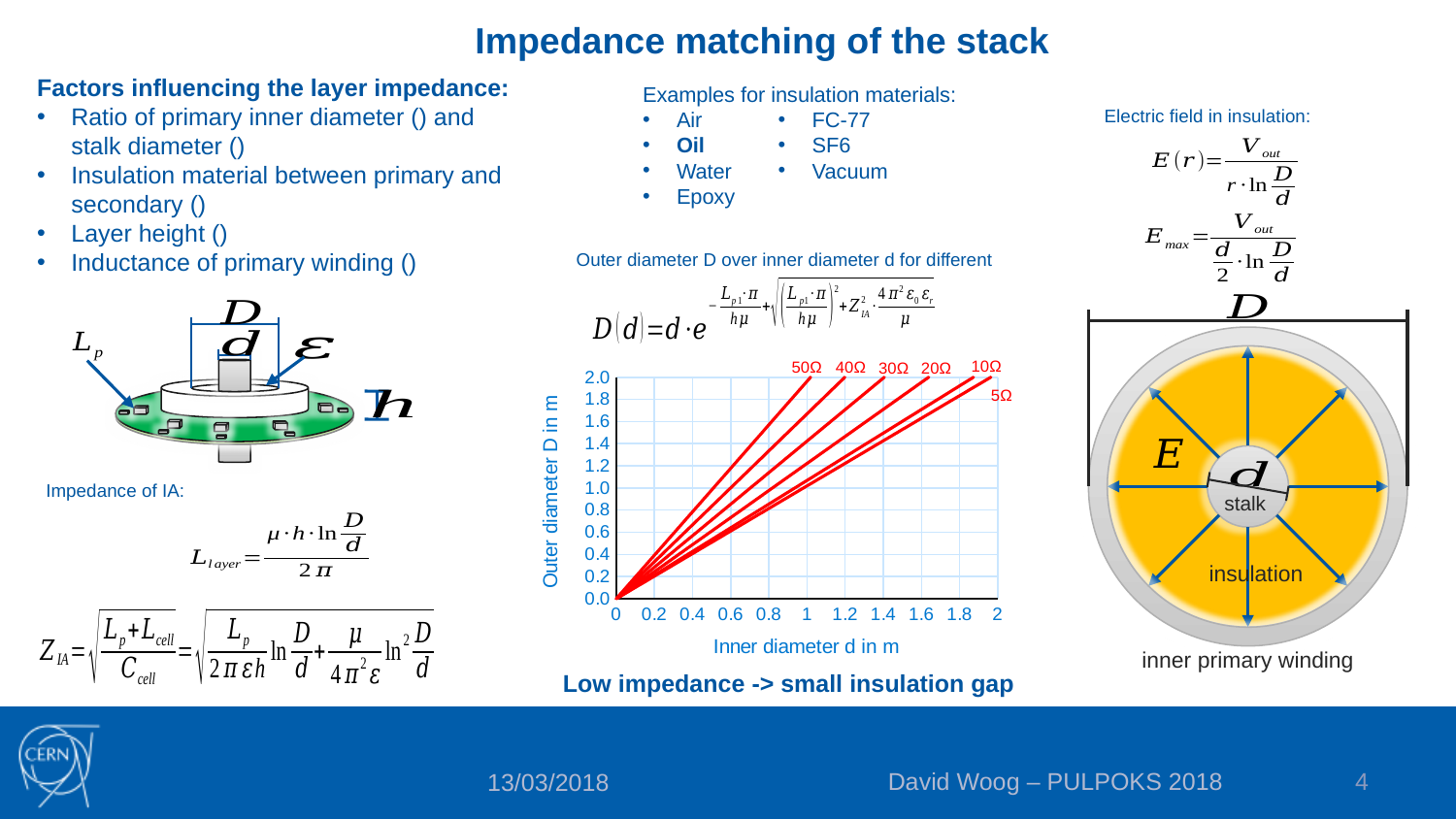
At an inner diameter of 1 m, is the outer diameter for the 50Ω curve greater or less than 1.6 m? greater What is the label of the y axis of the chart? Outer diameter D in m At an inner diameter of 0.5 m, is the outer diameter for the 50Ω curve greater or less than 0.8 m? greater Which impedance curve is the steepest in the chart? 50Ω Do the curves in the chart rise or fall as the inner diameter d increases? rise What kind of chart is shown on the slide? line chart What is the highest value shown on the y axis of the chart? 2.0 At the same inner diameter, which curve gives the larger outer diameter, 50Ω or 5Ω? 50Ω At an inner diameter of 1 m, is the outer diameter for the 5Ω curve greater or less than 1.2 m? less Which impedance curve lies lowest in the chart? 5Ω How many impedance curves are plotted in the chart? 6 What is the label of the x axis of the chart? Inner diameter d in m